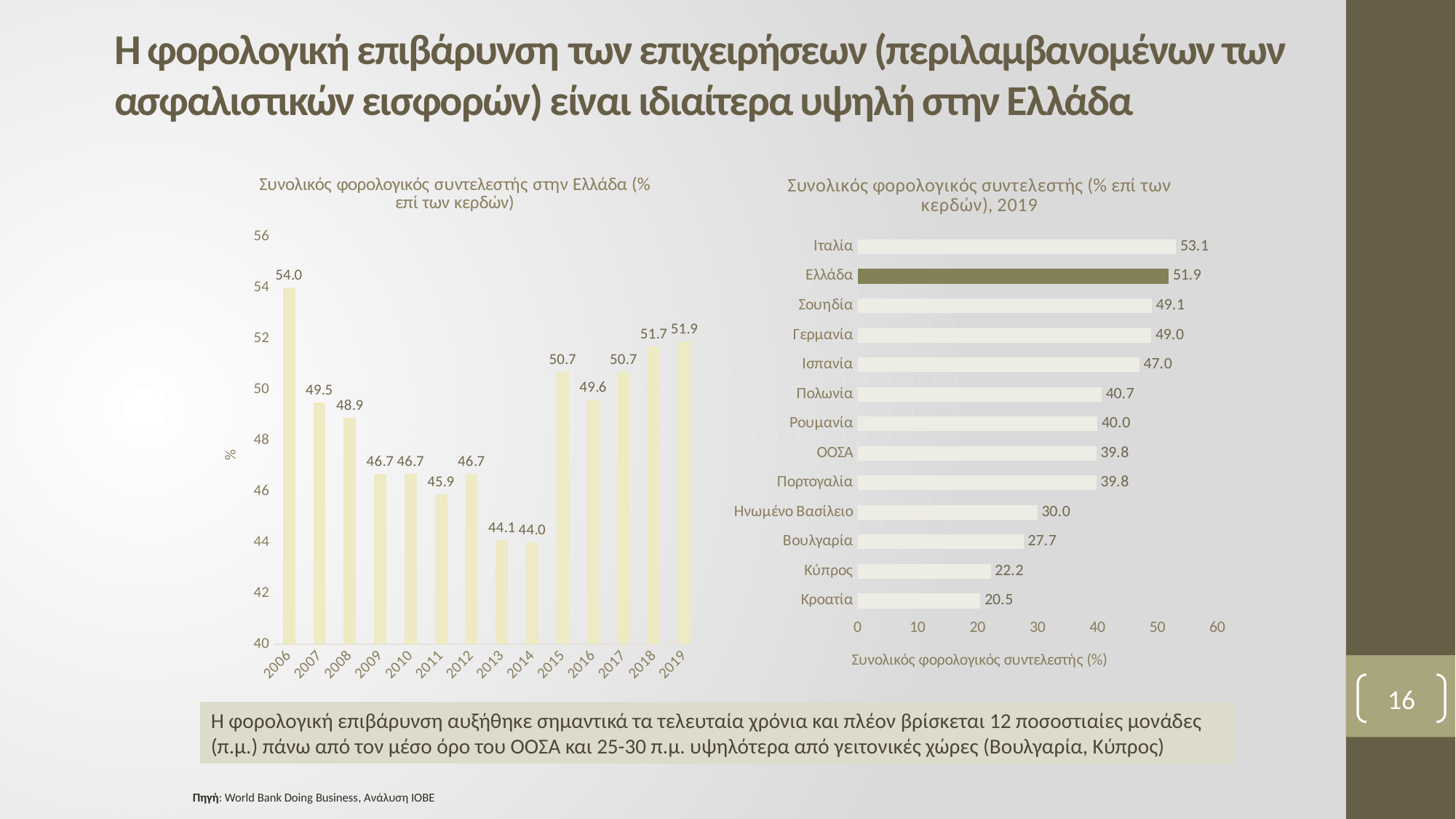
In the right chart (Συνολικός φορολογικός συντελεστής, 2019), what is the value for Ελλάδα? 51.9 In the right chart (Συνολικός φορολογικός συντελεστής, 2019), how many categories are listed? 13 In the left chart (Συνολικός φορολογικός συντελεστής στην Ελλάδα), how many years are shown on the x axis? 14 In the right chart (Συνολικός φορολογικός συντελεστής, 2019), what is the difference between the values for Ελλάδα and ΟΟΣΑ? 12.1 In the right chart (Συνολικός φορολογικός συντελεστής, 2019), which country has the highest value? Ιταλία In the left chart (Συνολικός φορολογικός συντελεστής στην Ελλάδα), do the values rise or fall from 2014 to 2019? rise In the left chart (Συνολικός φορολογικός συντελεστής στην Ελλάδα), what is the value for 2006? 54.0 In the left chart (Συνολικός φορολογικός συντελεστής στην Ελλάδα), what is the difference between the values for 2019 and 2014? 7.9 In the left chart (Συνολικός φορολογικός συντελεστής στην Ελλάδα), which is larger, the value for 2007 or the value for 2016? 2016 In the right chart (Συνολικός φορολογικός συντελεστής, 2019), which category has the lowest value? Κροατία In the left chart (Συνολικός φορολογικός συντελεστής στην Ελλάδα), which year has the lowest value? 2014 What type of chart is the right chart (Συνολικός φορολογικός συντελεστής, 2019)? bar chart